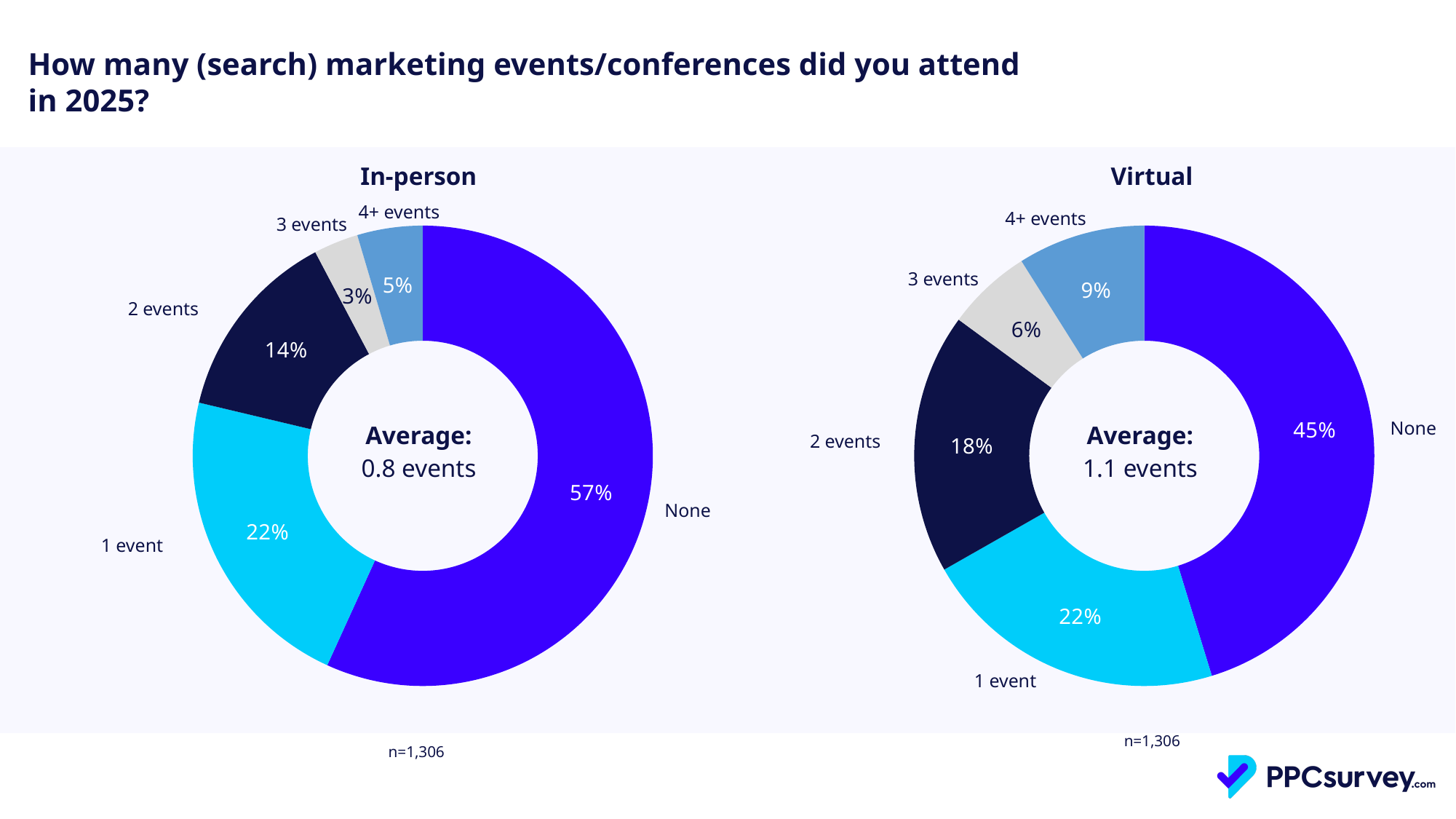
In the Virtual chart, what percentage attended 4+ events? 9% In the In-person chart, which category has the largest share? None What is the average number of in-person events shown in the centre of the In-person chart? 0.8 events In the Virtual chart, which category has the smallest share? 3 events Which is larger: the 2 events share in the In-person chart or the 2 events share in the Virtual chart? Virtual What kind of chart is used for the Virtual data? Donut (pie) chart How many categories does the In-person chart show? 5 In the In-person chart, what percentage of respondents attended no events? 57% What sample size (n) is shown for the Virtual chart? n=1,306 In the Virtual chart, what percentage of respondents attended 2 events? 18% In the In-person chart, what percentage attended 3 events? 3% What is the difference between the 'None' share in the In-person chart and the 'None' share in the Virtual chart? 12 percentage points